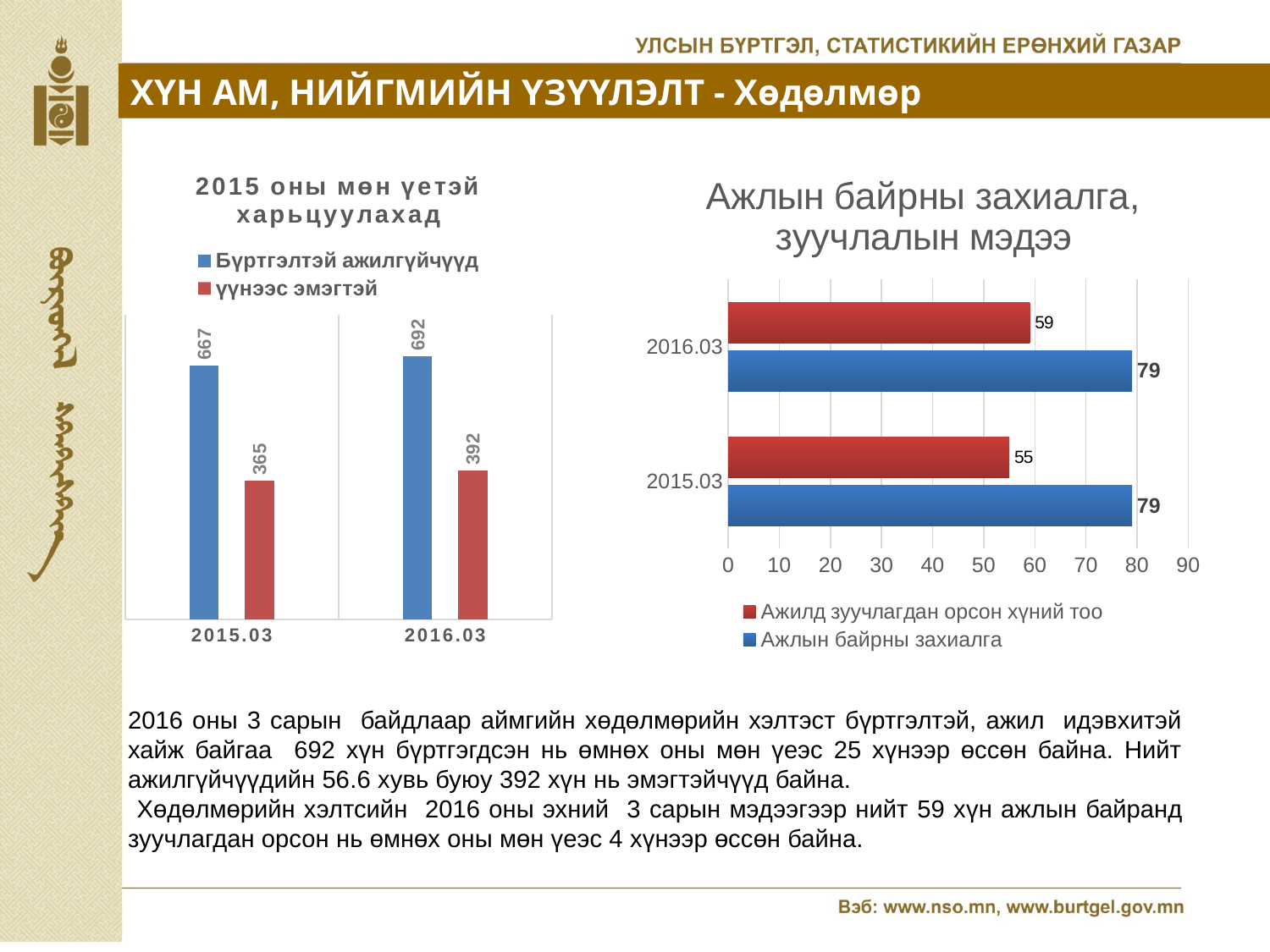
In the right chart 'Ажлын байрны захиалга, зуучлалын мэдээ', what is the value for Ажлын байрны захиалга in 2015.03? 79 In the right chart 'Ажлын байрны захиалга, зуучлалын мэдээ', what is the difference between Ажилд зуучлагдан орсон хүний тоо in 2016.03 and in 2015.03? 4 In the left chart '2015 оны мөн үетэй харьцуулахад', how many series does the legend list? 2 What kind of chart is the left chart '2015 оны мөн үетэй харьцуулахад'? Bar chart In the right chart 'Ажлын байрны захиалга, зуучлалын мэдээ', which series is shown in blue? Ажлын байрны захиалга In the right chart 'Ажлын байрны захиалга, зуучлалын мэдээ', how many categories are shown on the vertical axis? 2 In the left chart '2015 оны мөн үетэй харьцуулахад', what is the difference between Бүртгэлтэй ажилгүйчүүд in 2016.03 and in 2015.03? 25 In the right chart 'Ажлын байрны захиалга, зуучлалын мэдээ', what is the maximum value shown on the horizontal axis? 90 In the left chart '2015 оны мөн үетэй харьцуулахад', which year has the higher value for үүнээс эмэгтэй? 2016.03 In the left chart '2015 оны мөн үетэй харьцуулахад', what is the value for Бүртгэлтэй ажилгүйчүүд in 2016.03? 692 In the right chart 'Ажлын байрны захиалга, зуучлалын мэдээ', what is the value for Ажилд зуучлагдан орсон хүний тоо in 2016.03? 59 In the left chart '2015 оны мөн үетэй харьцуулахад', what is the value for үүнээс эмэгтэй in 2015.03? 365